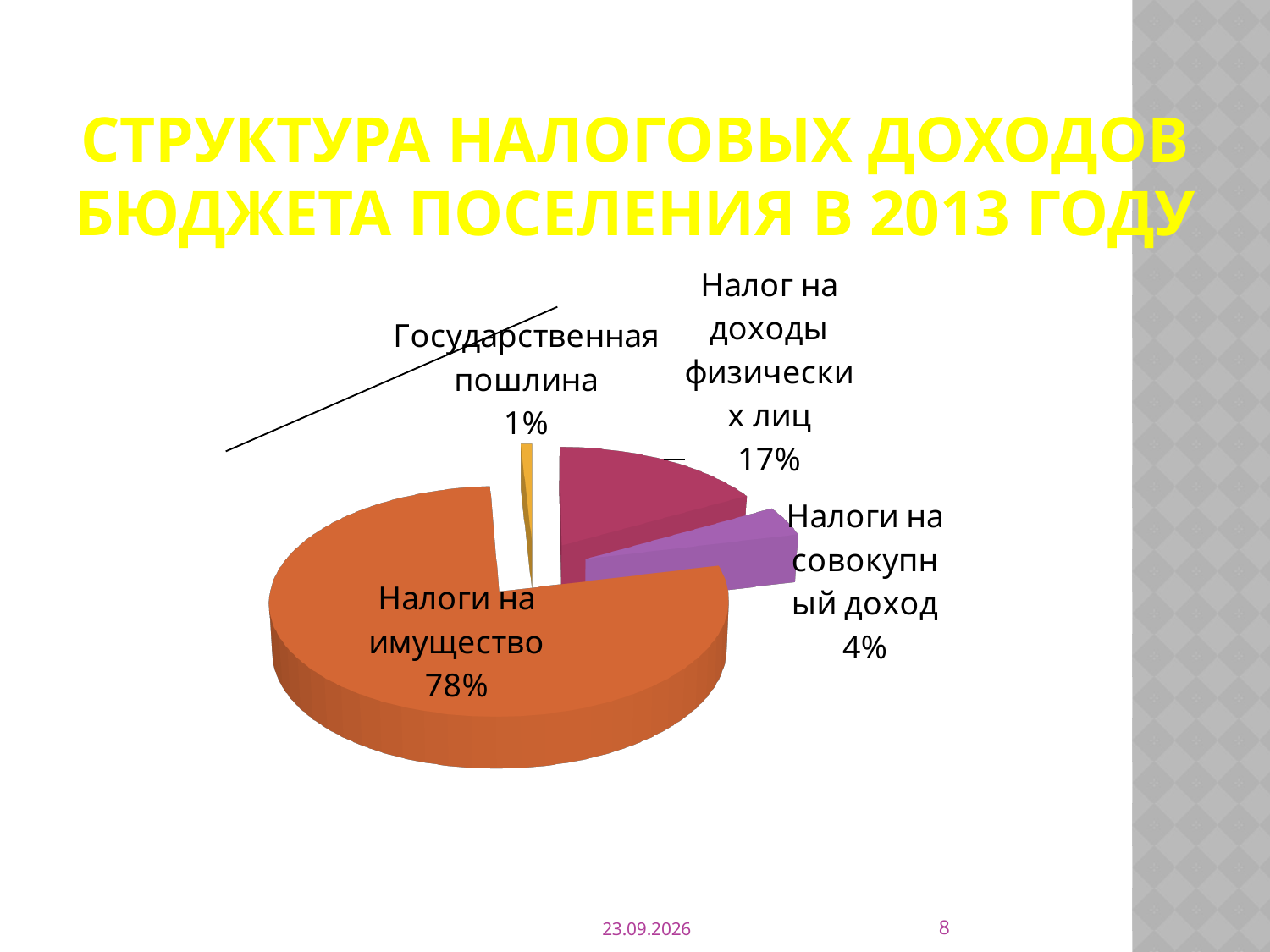
Which is larger: Налоги на совокупный доход or Государственная пошлина? Налоги на совокупный доход What kind of chart is shown on the slide? Pie chart What is the value shown for Государственная пошлина? 1% What is the difference between the shares of Налоги на имущество and Налог на доходы физических лиц? 61% Which category has the smallest slice of the pie? Государственная пошлина What is the difference between the shares of Налог на доходы физических лиц and Налоги на совокупный доход? 13% What colour is the slice for Налоги на имущество? Orange What share of the pie does Налоги на имущество have? 78% How many categories are shown in the pie chart? 4 What is the value shown for Налоги на совокупный доход? 4% What is the value shown for Налог на доходы физических лиц? 17% Which category has the largest slice of the pie? Налоги на имущество